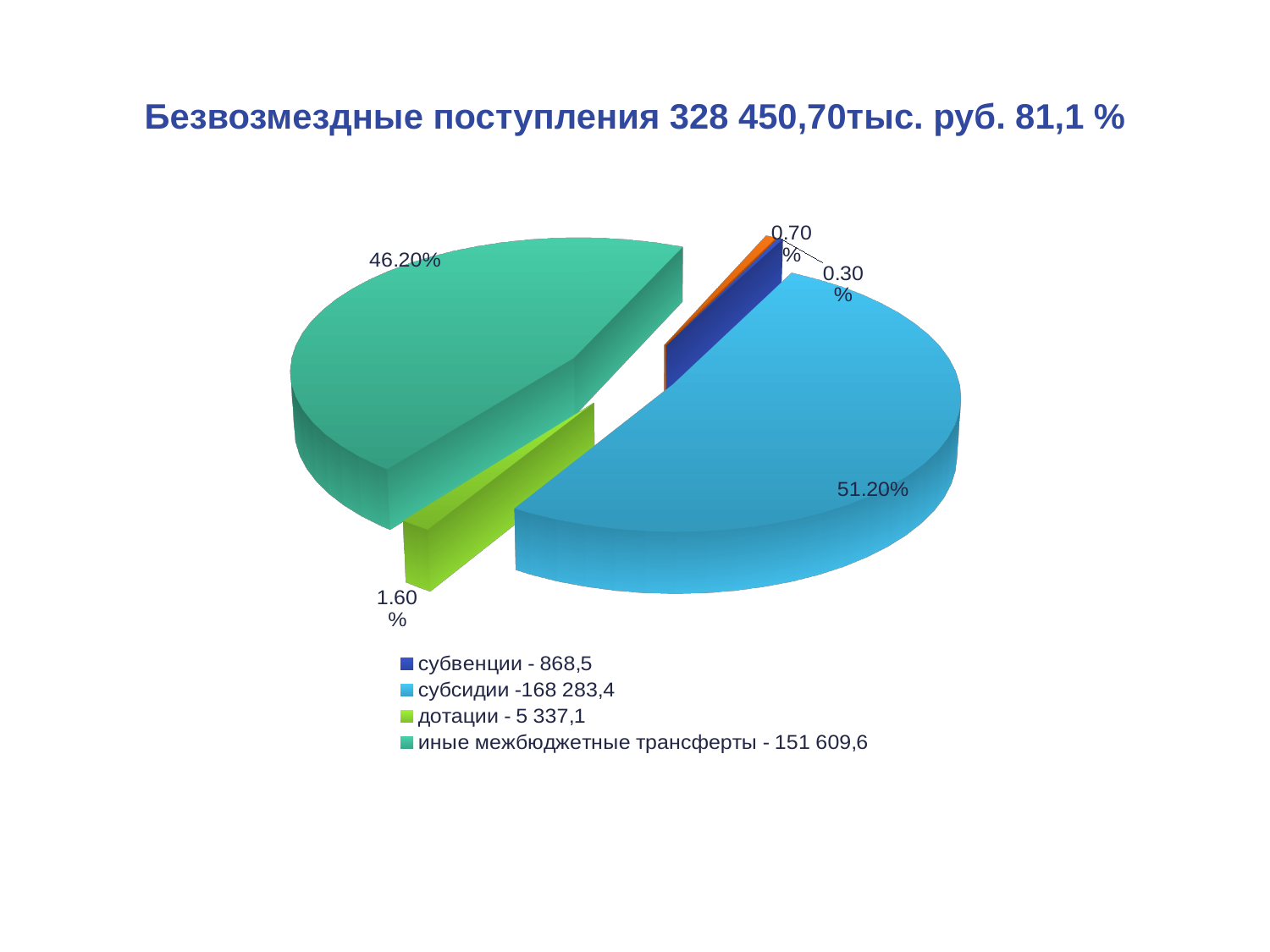
Which category has the largest slice of the pie? субсидии Which legend category has the smallest slice of the pie? субвенции What share of the pie does субвенции take? 0.30% What is the difference in percentage points between the субсидии slice and the иные межбюджетные трансферты slice? 5.00% What is the title of the chart? Безвозмездные поступления 328 450,70тыс. руб. 81,1 % What share of the pie does дотации take? 1.60% What share of the pie does субсидии take? 51.20% Which is larger, the slice for субсидии or the slice for иные межбюджетные трансферты? субсидии What kind of chart is shown on the slide? pie chart How many entries does the legend list? 4 What value is given for субсидии in the legend? 168 283,4